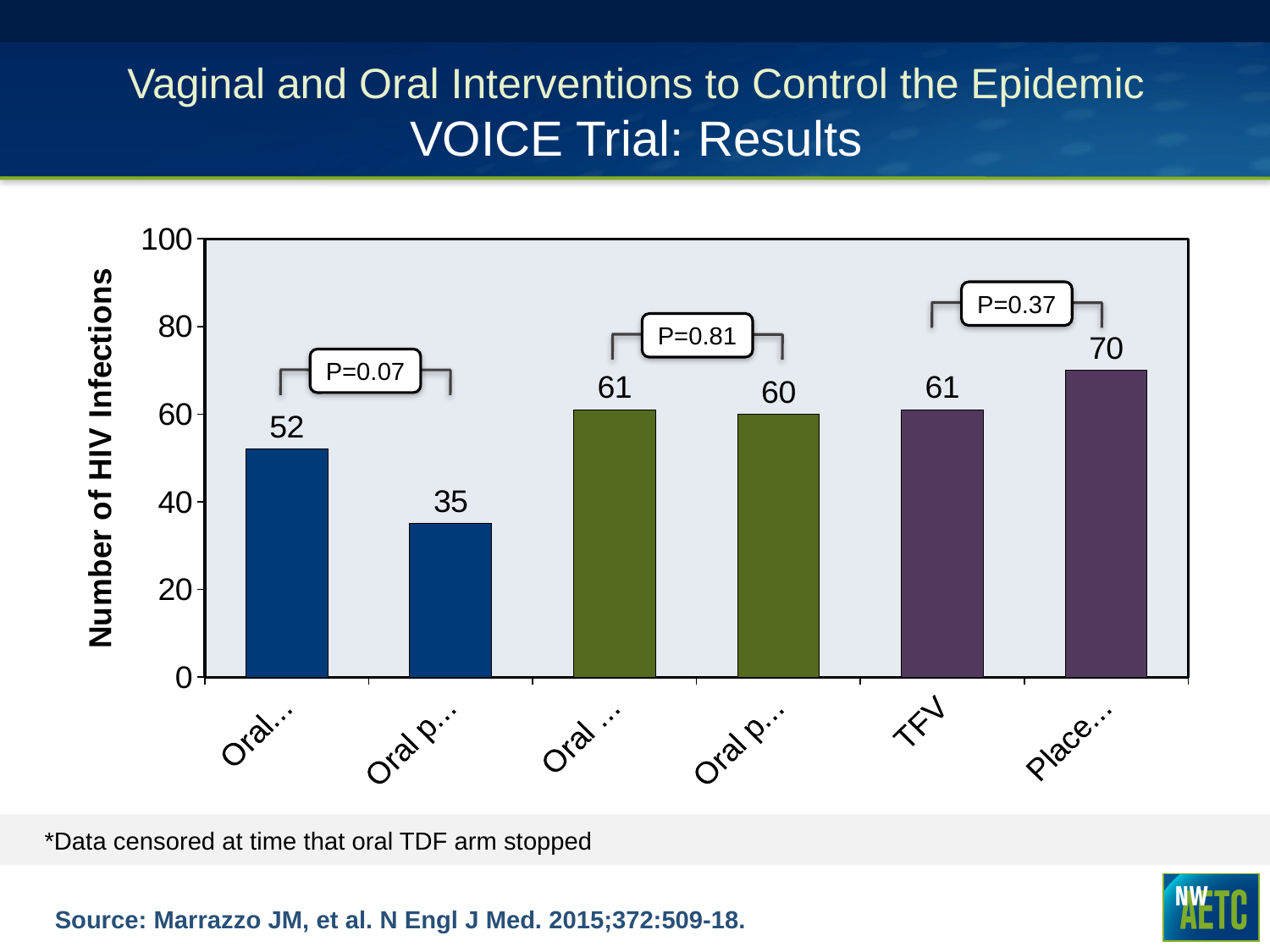
What value is shown on the rightmost bar? 70 What is the lowest number of HIV infections shown on the chart? 35 Which is larger, the TFV bar or the second bar from the left? TFV What value is shown on the first (leftmost) bar? 52 What is the difference between the rightmost bar and the TFV bar? 9 What is the number of HIV infections for TFV? 61 What is the highest number of HIV infections shown on the chart? 70 How many bars are shown on the chart? 6 What kind of chart is shown on the slide? bar chart What is the difference between the first and second bars from the left? 17 What P-value is shown above the first two bars? P=0.07 What value is shown on the second bar from the left? 35